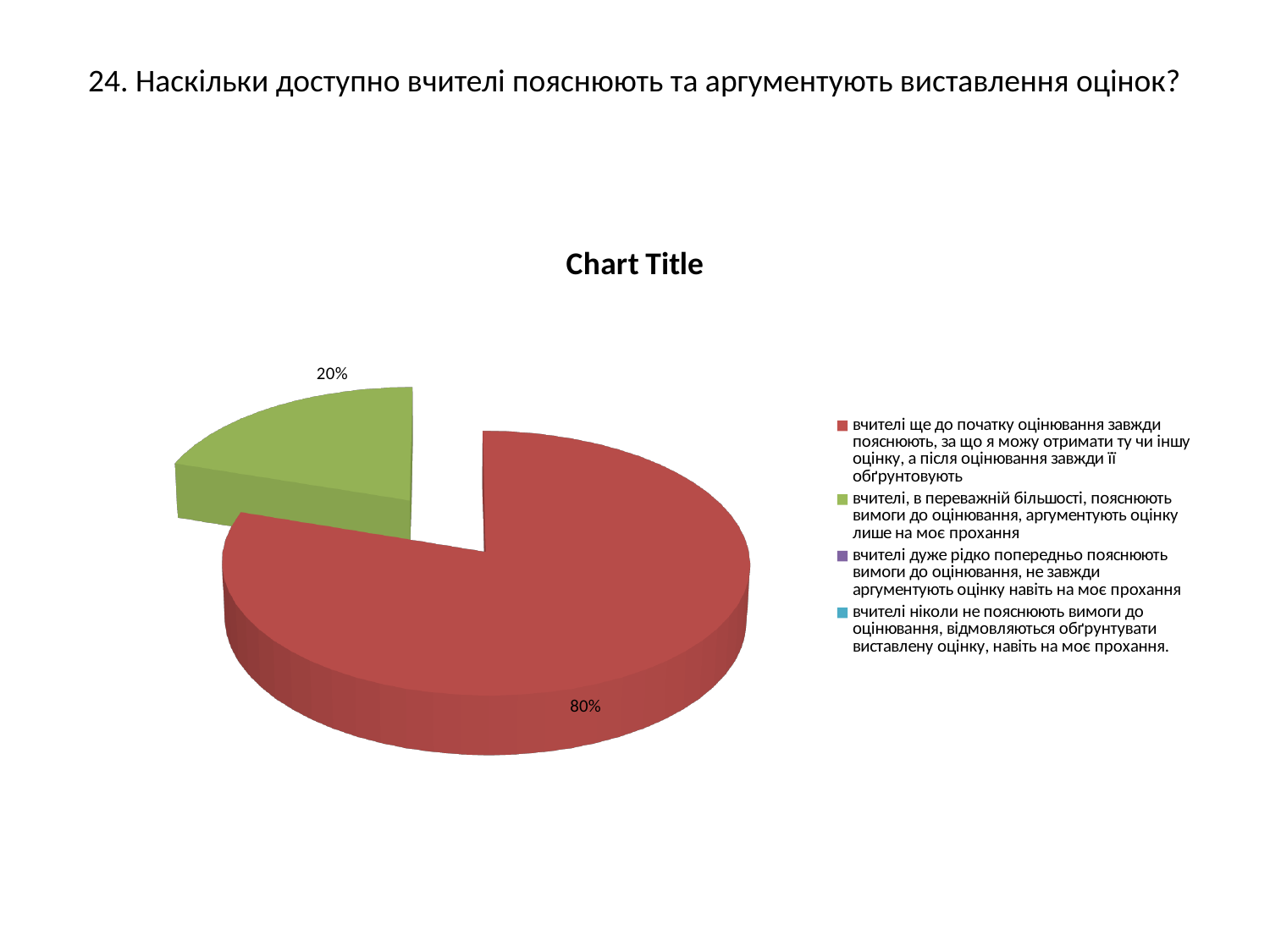
How many entries does the legend list? 4 What percentage is shown for the red slice (teachers always explain grading requirements before assessment and always justify the grade afterwards)? 80% What is the title printed above the chart? Chart Title What share of the pie does the green slice represent? 20% Which of the two labelled slices is smaller, the red one or the green one? the green one Which slice is larger, the red slice or the green slice? the red slice What is the difference in percentage points between the red slice and the green slice? 60 What type of chart is shown on the slide? pie chart Which legend category has the largest share of the pie? вчителі ще до початку оцінювання завжди пояснюють, за що я можу отримати ту чи іншу оцінку, а після оцінювання завжди її обґрунтовують How many slices with data labels are visible in the pie? 2 What percentage is shown for the green slice (teachers mostly explain grading requirements, justify the grade only on my request)? 20% What colour is the slice labelled 80%? red